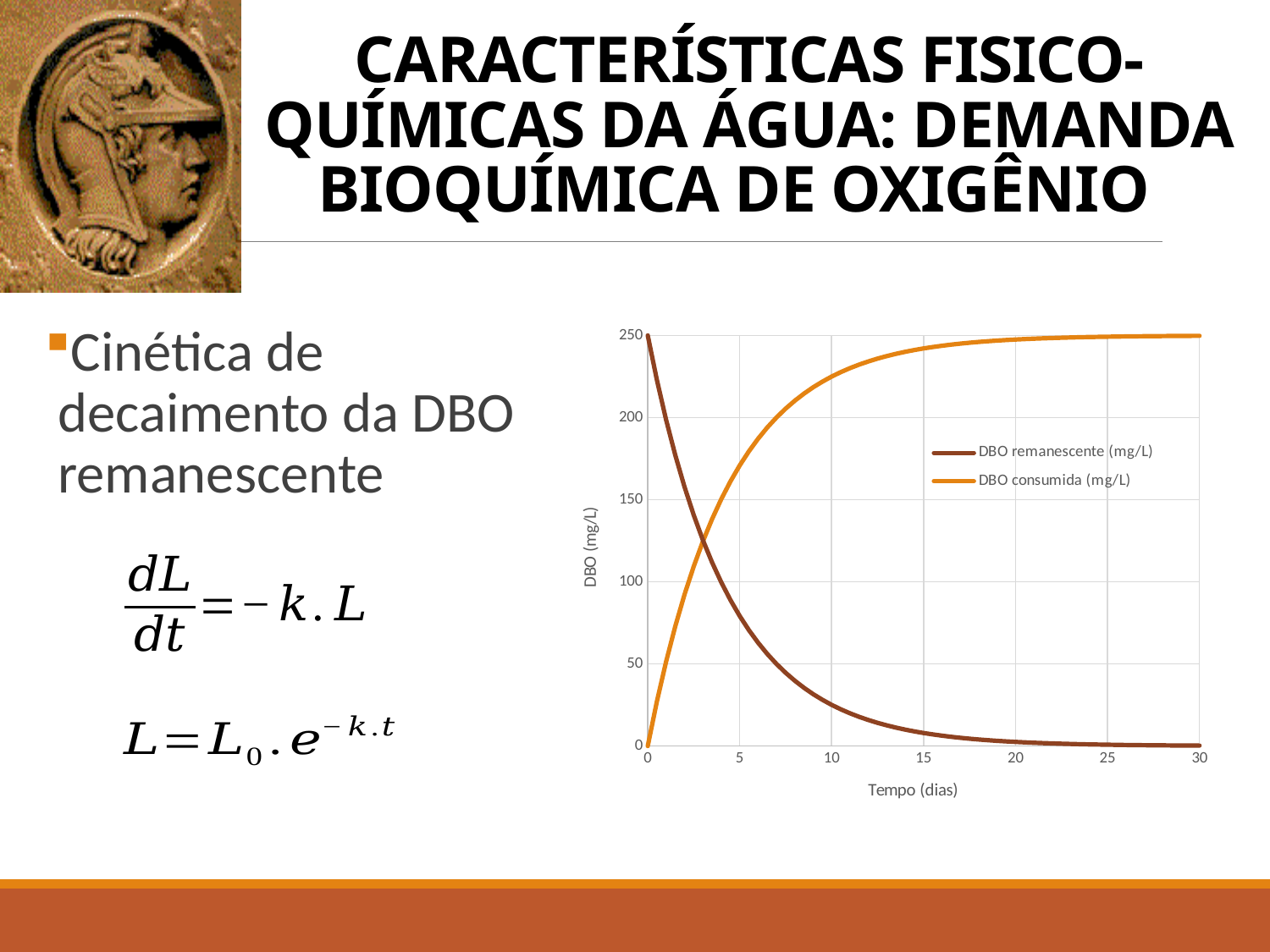
At 10 days, which series has the larger value, DBO remanescente (mg/L) or DBO consumida (mg/L)? DBO consumida (mg/L) Does the DBO remanescente (mg/L) series rise or fall as time increases? fall Is the value of DBO remanescente (mg/L) at 10 days greater or less than 50? less What is the value of DBO remanescente (mg/L) at time 0? 250 How many series does the chart legend list? 2 What is the value of DBO consumida (mg/L) at time 0? 0 Is the value of DBO consumida (mg/L) at 10 days greater or less than 200? greater Is the value of DBO remanescente (mg/L) at 5 days greater or less than 100? less Does the DBO consumida (mg/L) series rise or fall as time increases? rise What are the two series named in the chart legend? DBO remanescente (mg/L) and DBO consumida (mg/L) What kind of chart is shown on the slide? line chart What is the label of the x axis of the chart? Tempo (dias)